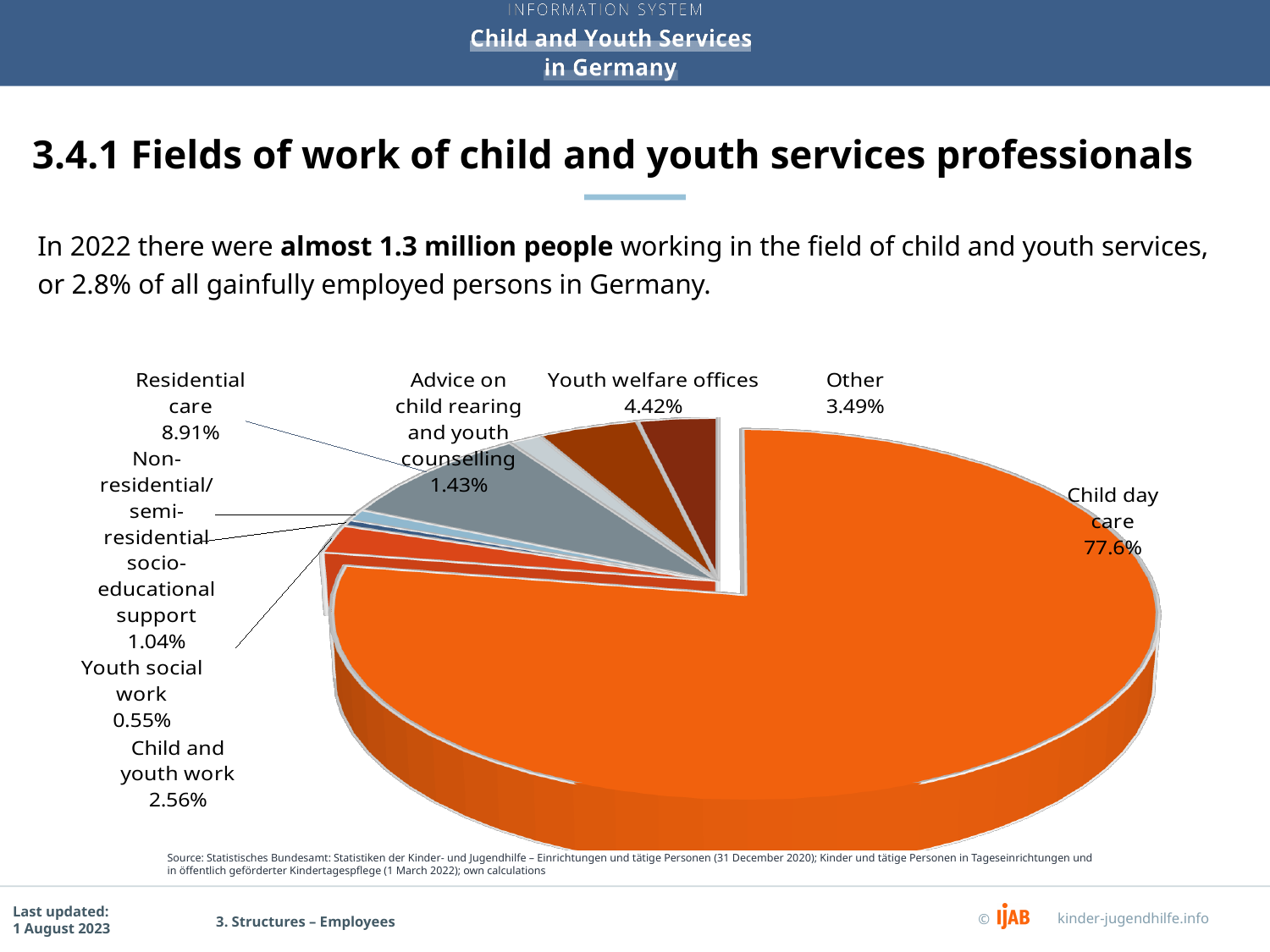
Which field of work has the largest share of the pie? Child day care What share of child and youth services professionals work in child day care? 77.6% How many fields of work are shown as slices in the pie chart? 8 What percentage is shown for residential care? 8.91% What percentage is shown for youth welfare offices? 4.42% Which field of work has the smallest share of the pie? Youth social work What is the difference in percentage points between residential care and youth welfare offices? 4.49 What percentage is shown for advice on child rearing and youth counselling? 1.43% What kind of chart is shown on the slide? Pie chart What percentage is shown for youth social work? 0.55% Which is larger, the share for Other or the share for child and youth work? Other What is the combined share of youth welfare offices and Other? 7.91%